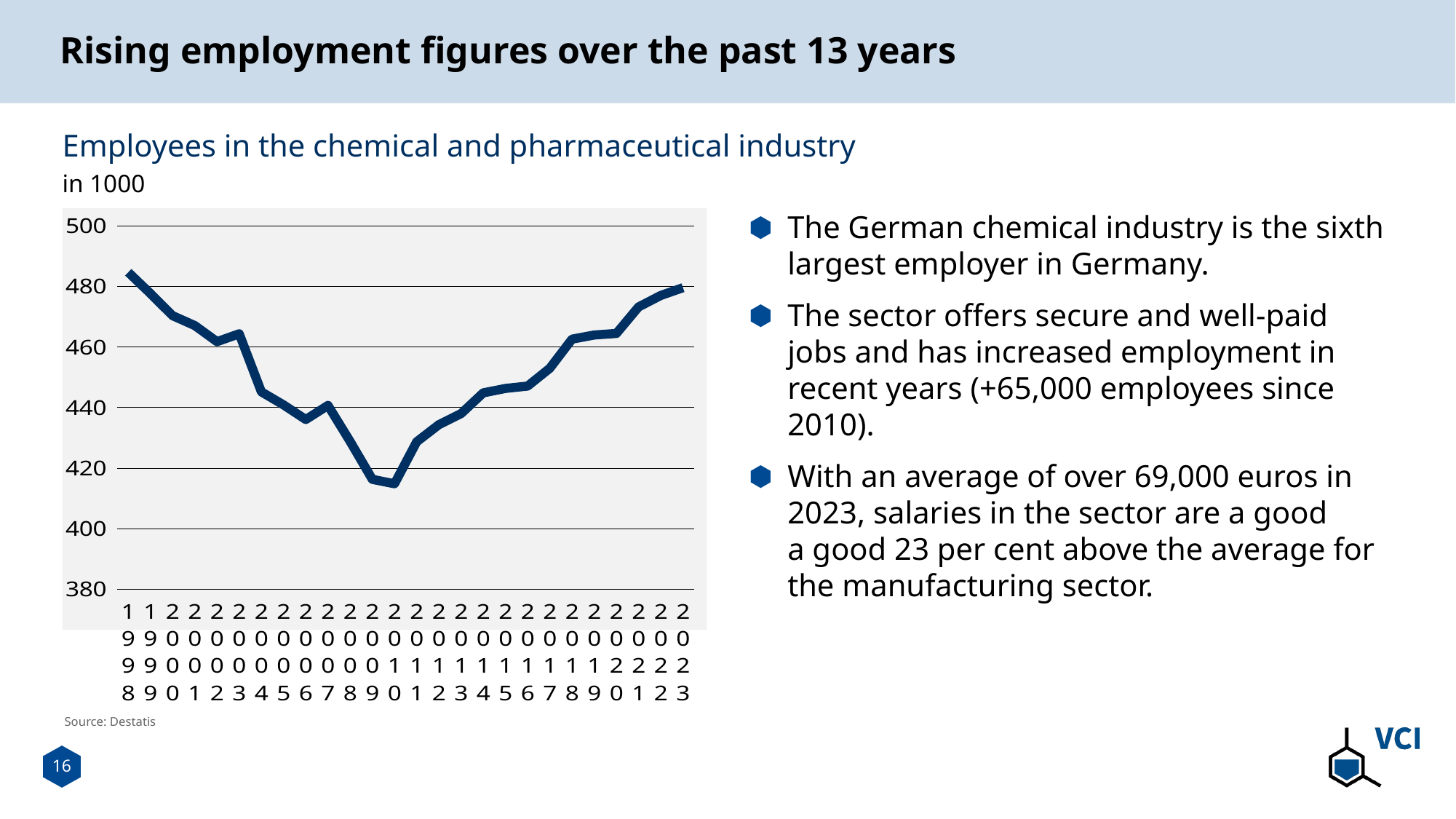
Do the values rise or fall from 1998 to 2010? fall Is the value for 2010 greater or less than 420? less Do the values rise or fall from 2010 to 2023? rise Is the value for 2006 greater or less than 440? less Is the value for 2023 greater or less than 460? greater What kind of chart is shown on the slide? line chart What is the first year shown on the x axis of the chart? 1998 Which is larger, the value for 2010 or the value for 2023? 2023 What is the last year shown on the x axis of the chart? 2023 How many years are plotted on the x axis of the chart? 26